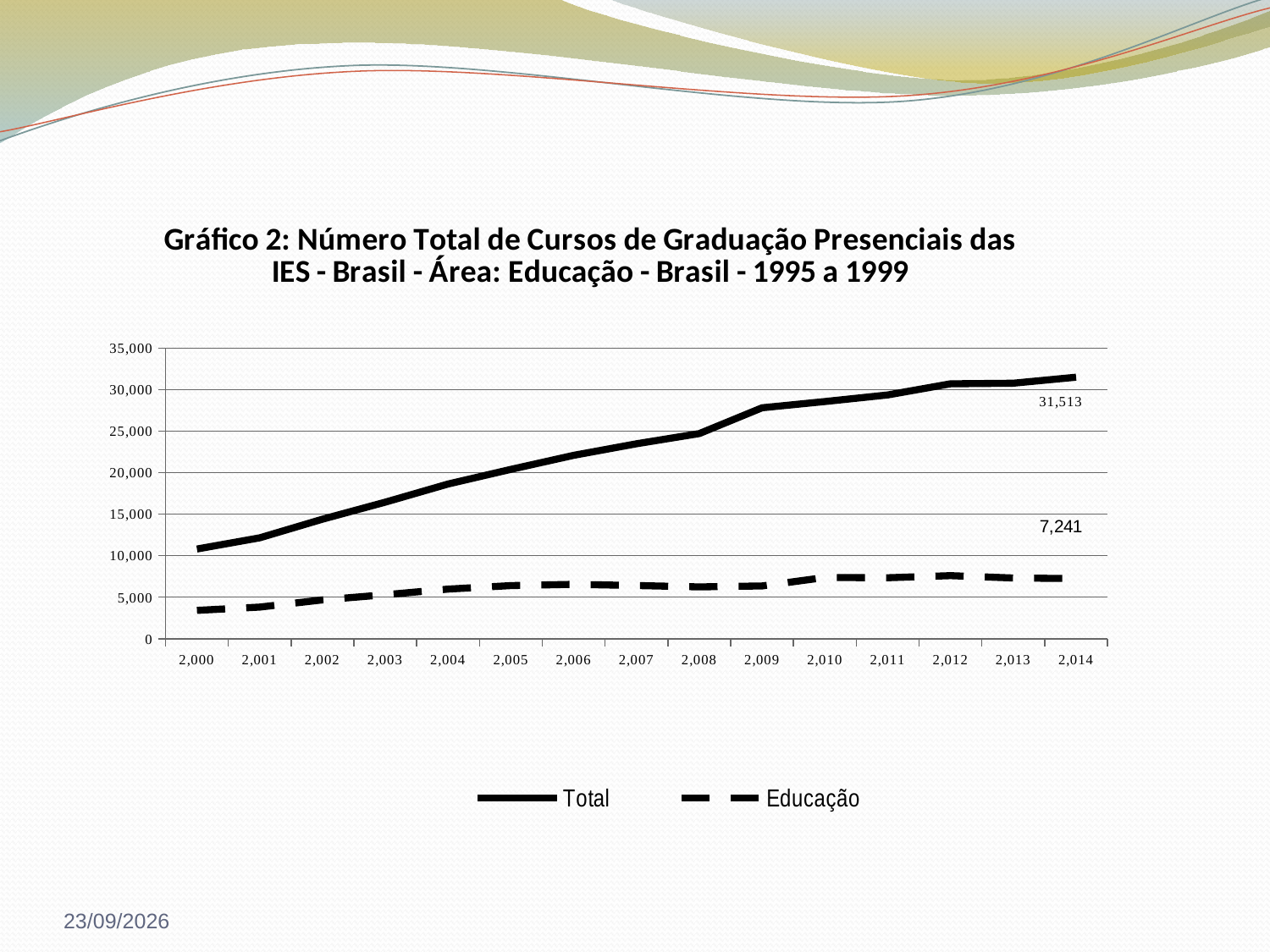
What is the value of the Educação series in 2,014? 7,241 How many series does the legend list? 2 In 2,014, which series has the larger value, Total or Educação? Total What is the value of the Total series in 2,014? 31,513 What is the difference between the Total and Educação values in 2,014? 24,272 Is the value for Total in 2,009 greater or less than 25,000? greater How many years are shown on the x axis? 15 What kind of chart is shown on the slide? line chart Does the Total series rise or fall from 2,000 to 2,014? rise Is the value for Total in 2,000 greater or less than 15,000? less Is the value for Educação in 2,000 greater or less than 5,000? less In which year is the Total series at its lowest? 2,000